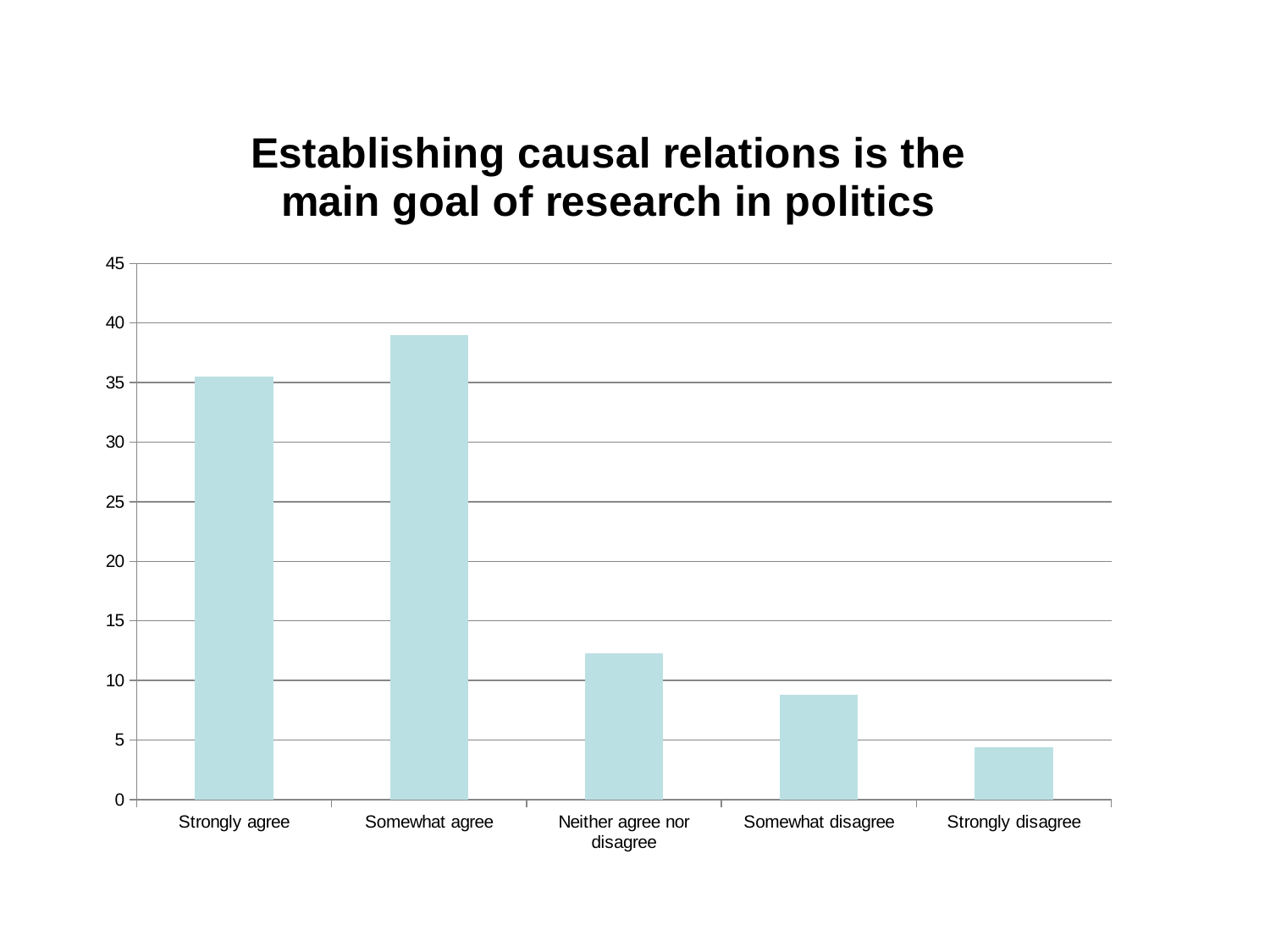
Which is larger, the value for Neither agree nor disagree or the value for Somewhat disagree? Neither agree nor disagree Is the value for Somewhat agree greater or less than 35? greater Is the value for Strongly disagree greater or less than 5? less Which category has the highest value? Somewhat agree Is the value for Somewhat disagree greater or less than 10? less Which category has the lowest value? Strongly disagree Which is larger, the value for Strongly agree or the value for Somewhat agree? Somewhat agree What is the title of the chart? Establishing causal relations is the main goal of research in politics What kind of chart is shown on the slide? bar chart How many categories are shown on the x axis? 5